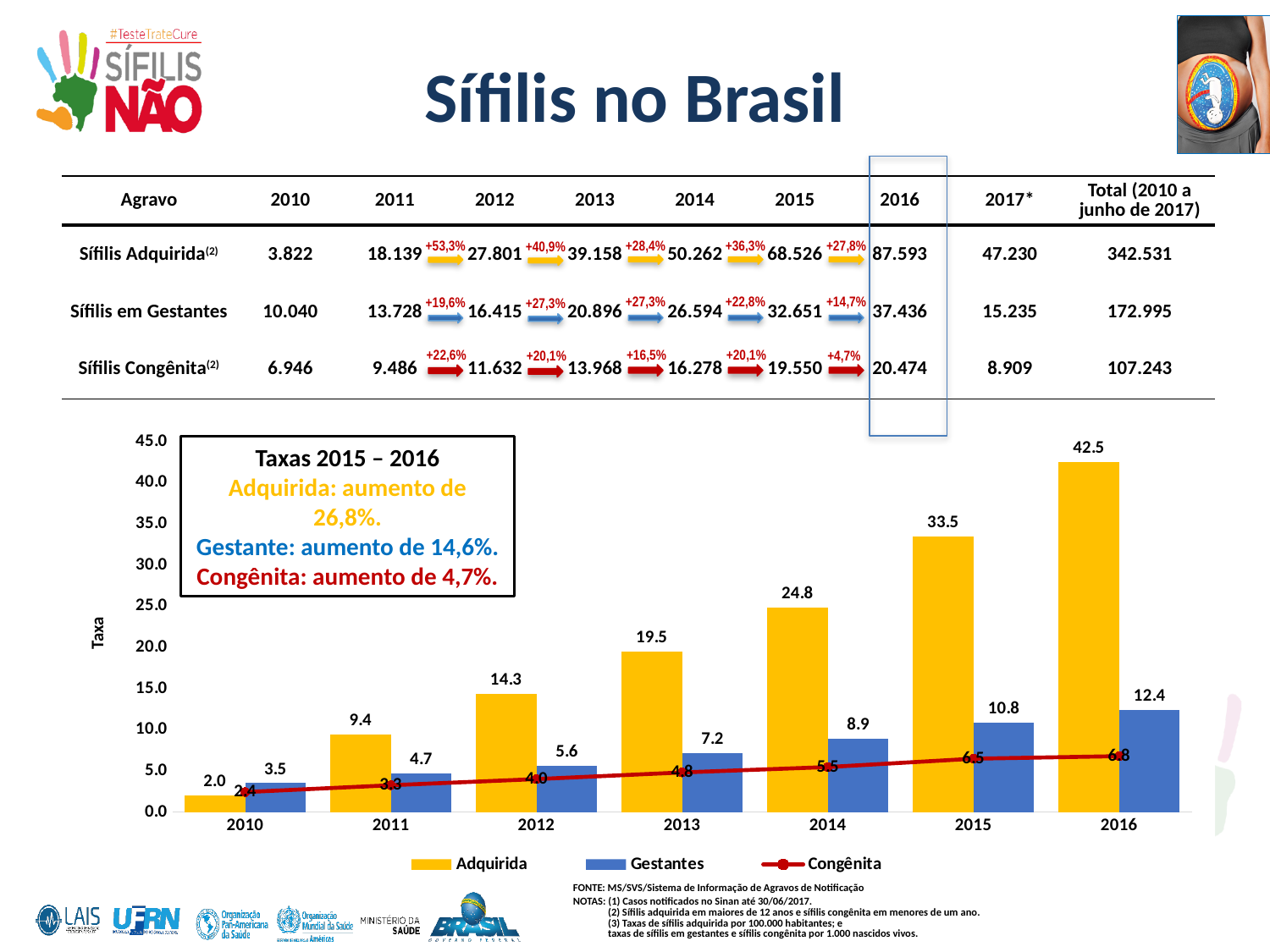
Does the Adquirida rate rise or fall from 2010 to 2016? rise How many years are shown on the x axis of the chart? 7 Which year has the lowest Gestantes rate in the chart? 2010 What is the difference between the Adquirida rate in 2016 and in 2015? 9.0 Which series in the chart is drawn as a line rather than bars? Congênita In 2010, which is larger: the Adquirida rate or the Gestantes rate? Gestantes Is the Adquirida rate for 2014 greater or less than 20.0? greater What is the Adquirida rate for 2013 in the chart? 19.5 What is the Gestantes rate for 2014 in the chart? 8.9 How many series does the chart legend list? 3 Which year has the highest Adquirida rate in the chart? 2016 What is the Adquirida rate for 2016 in the chart? 42.5